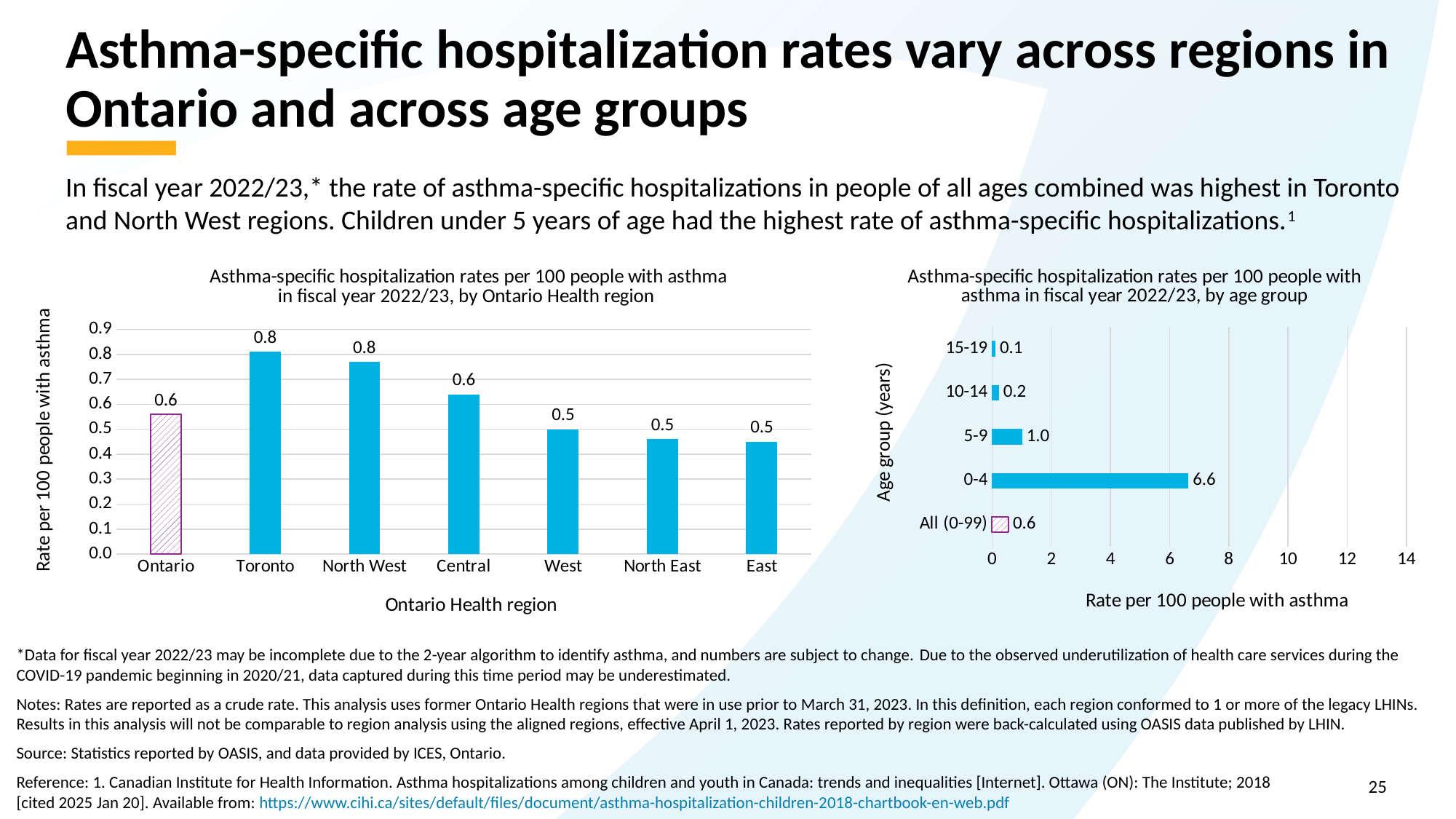
In the chart by Ontario Health region, what is the difference between the rates for Toronto and West? 0.3 In the chart by age group, which age group has the lowest rate? 15-19 How many regions (including Ontario) are shown in the chart by Ontario Health region? 7 In the chart by age group, what is the rate for the 15-19 age group? 0.1 In the chart by Ontario Health region, what is the rate for Central? 0.6 In the chart by age group, what is the rate for the 0-4 age group? 6.6 In the chart by age group, which age group has the highest rate? 0-4 What kind of chart is the chart by age group? Bar chart In the chart by age group, what is the difference between the rates for the 0-4 and 5-9 age groups? 5.6 In the chart by Ontario Health region, is the value for Central greater or less than 0.5? greater In the chart by Ontario Health region, which has the higher rate, Toronto or Central? Toronto In the chart by Ontario Health region, what is the rate for Toronto? 0.8